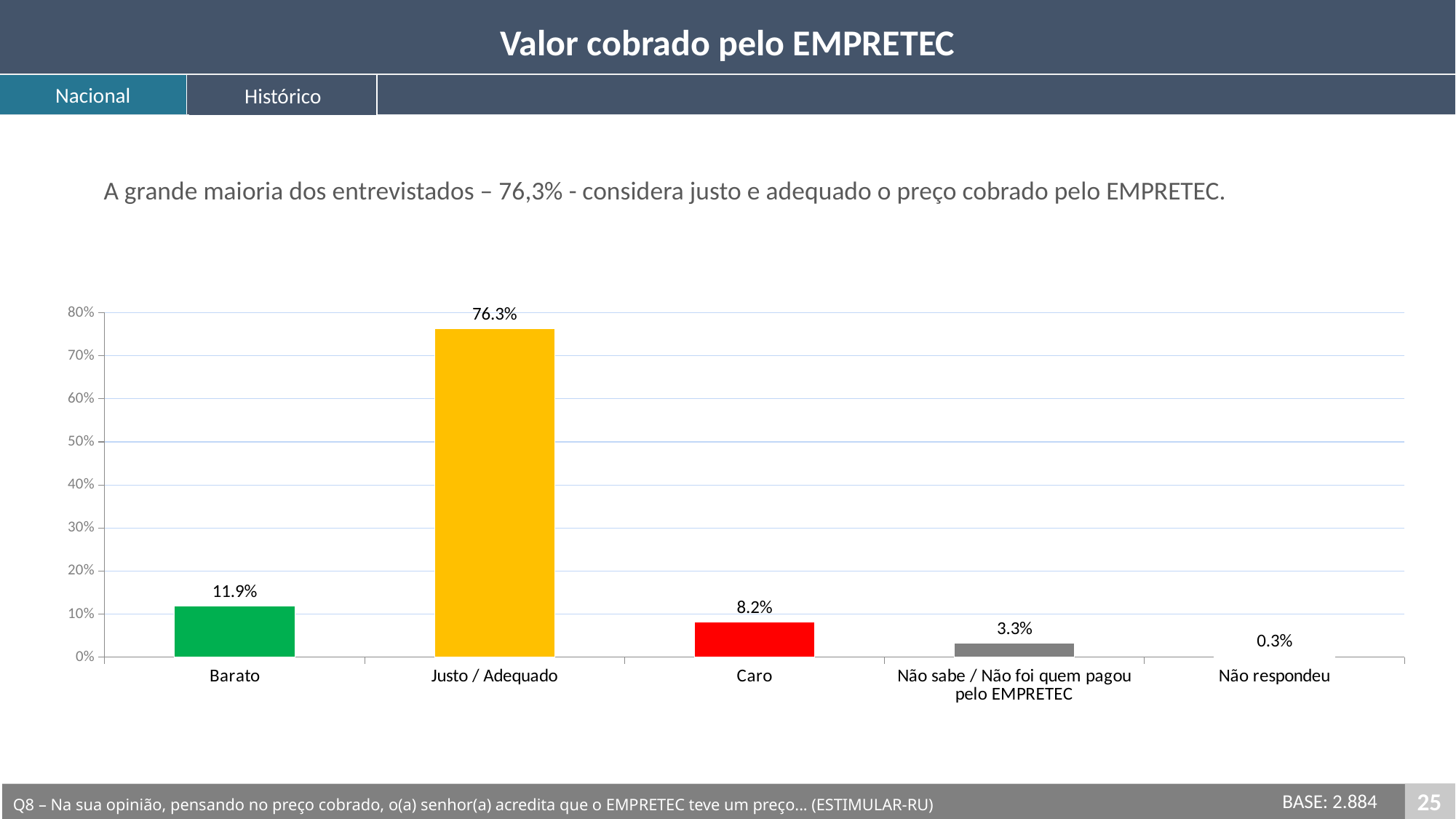
Which is larger, the value for Caro or the value for Não sabe / Não foi quem pagou pelo EMPRETEC? Caro What kind of chart is shown on the slide? bar chart What colour is the bar for Caro? red Which category has the lowest value? Não respondeu How many categories are shown on the x axis? 5 Which category has the highest value? Justo / Adequado Is the value for Justo / Adequado greater or less than 70%? greater What is the value for Barato? 11.9% What is the value for Justo / Adequado? 76.3% What is the difference between the values for Barato and Caro? 3.7% What is the value for Não sabe / Não foi quem pagou pelo EMPRETEC? 3.3% What is the value for Caro? 8.2%